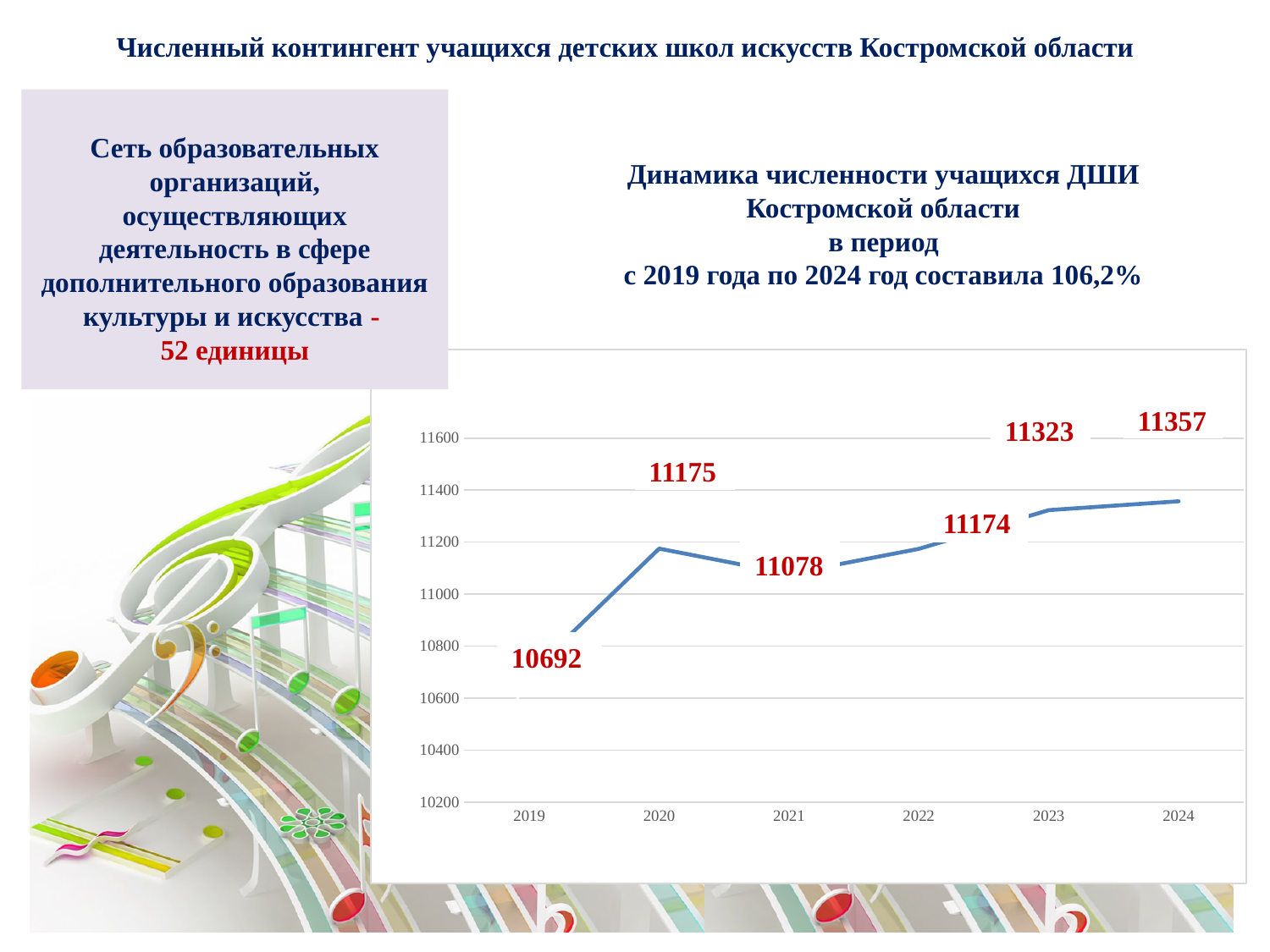
What is the value for 2023? 11323 How many years are plotted on the x axis? 6 Is the value for 2019 greater or less than 11000? less Which year has the lowest value? 2019 What is the difference between the values for 2024 and 2019? 665 Do the values generally rise or fall from 2019 to 2024? rise Which is larger, the value for 2020 or the value for 2021? 2020 What kind of chart is shown on the slide? line chart What is the value for 2021? 11078 Which year has the highest value? 2024 What is the value for 2019? 10692 What is the first year shown on the x axis? 2019